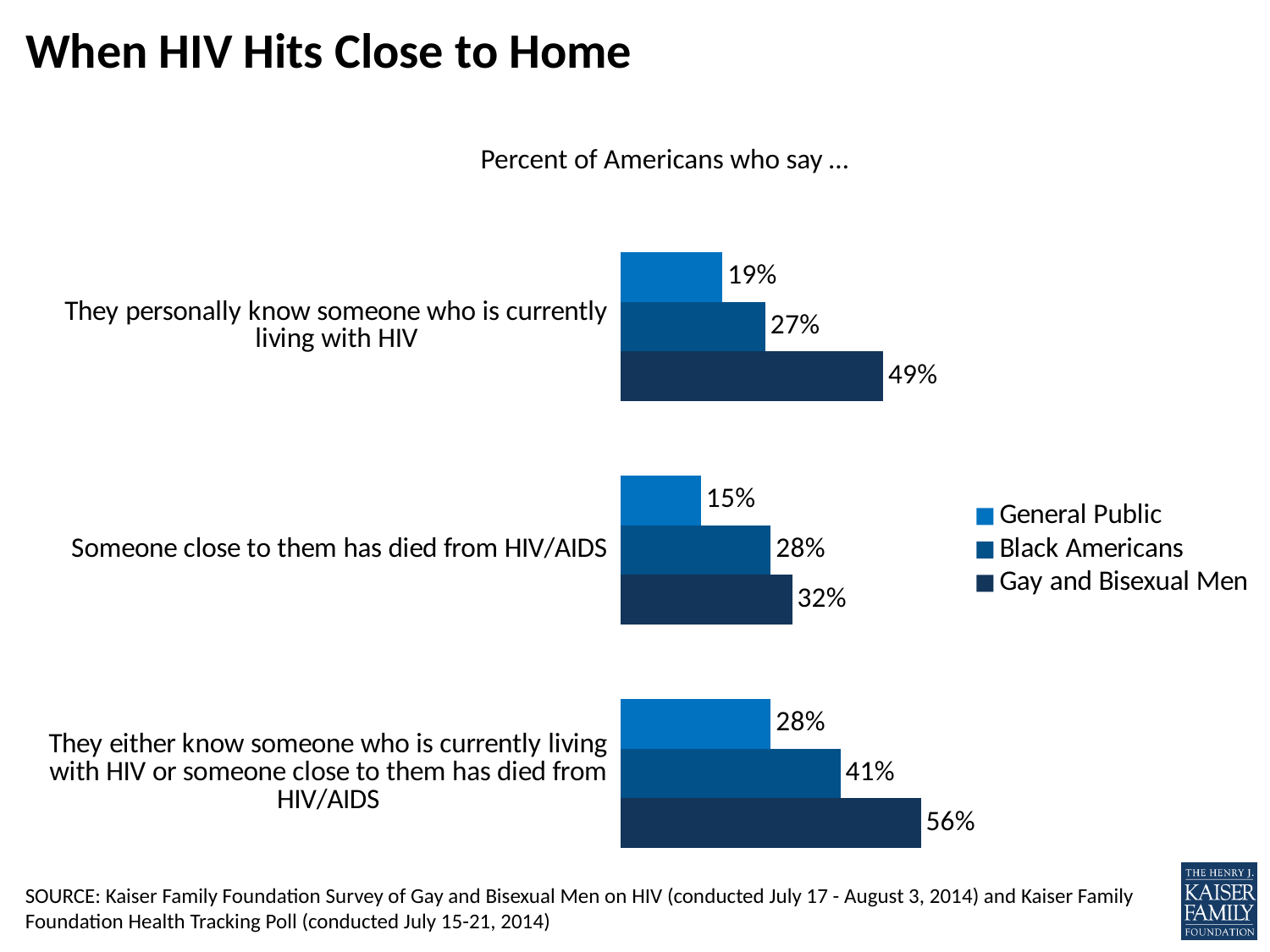
What kind of chart is shown on the slide? Bar chart What percent of Black Americans say they either know someone currently living with HIV or someone close to them has died from HIV/AIDS? 41% Which is larger: the Gay and Bisexual Men value for personally knowing someone living with HIV, or the Black Americans value for the combined measure? Gay and Bisexual Men (49%) What percent of Gay and Bisexual Men say someone close to them has died from HIV/AIDS? 32% What is the difference between Black Americans and the General Public for personally knowing someone currently living with HIV? 8% How many series does the legend list? 3 How many categories are shown on the chart? 3 Which group has the highest value for personally knowing someone who is currently living with HIV? Gay and Bisexual Men What is the difference between Gay and Bisexual Men and the General Public for either knowing someone living with HIV or someone close to them having died from HIV/AIDS? 28% What percent of the General Public say they personally know someone who is currently living with HIV? 19% Which group has the lowest value for someone close to them having died from HIV/AIDS? General Public Which is larger: the Black Americans value for someone close to them having died from HIV/AIDS, or the General Public value for either knowing someone living with HIV or someone close having died? They are equal (28%)